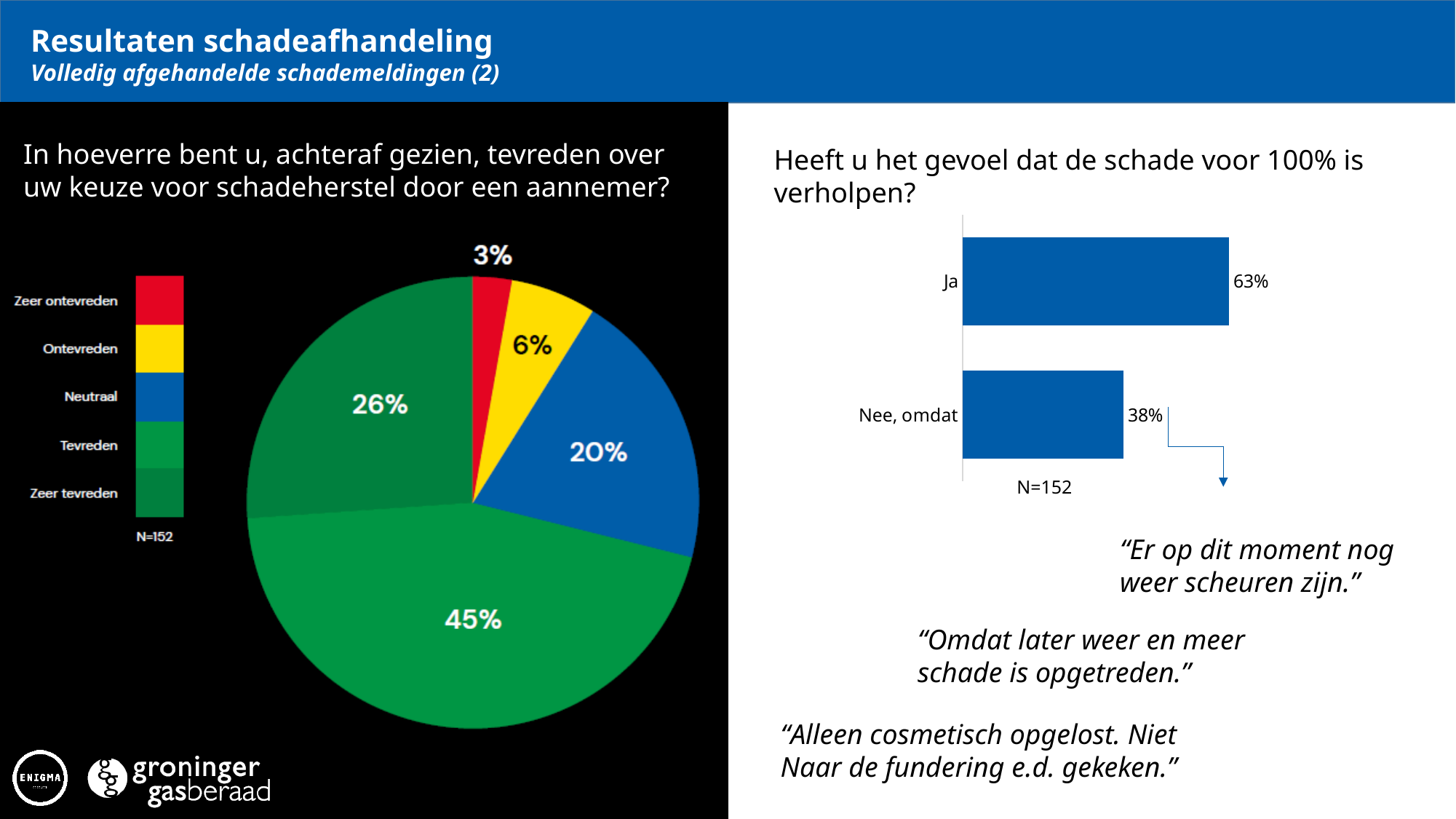
On the left chart, which category has the largest slice? Tevreden On the left chart, what is the difference between the 'Tevreden' and 'Zeer tevreden' shares? 19 percentage points On the left chart, what share of respondents answered 'Neutraal'? 20% On the left chart, how many categories does the legend list? 5 On the right chart, what percentage answered 'Ja'? 63% On the left chart, what share of respondents answered 'Zeer tevreden'? 26% What kind of chart is shown on the right side of the slide? Bar chart On the left chart, which category has the smallest slice? Zeer ontevreden What kind of chart is shown on the left side of the slide? Pie chart On the left chart, what share of respondents answered 'Tevreden'? 45% On the right chart, what percentage answered 'Nee, omdat'? 38% On the left chart, what share of respondents answered 'Zeer ontevreden'? 3%